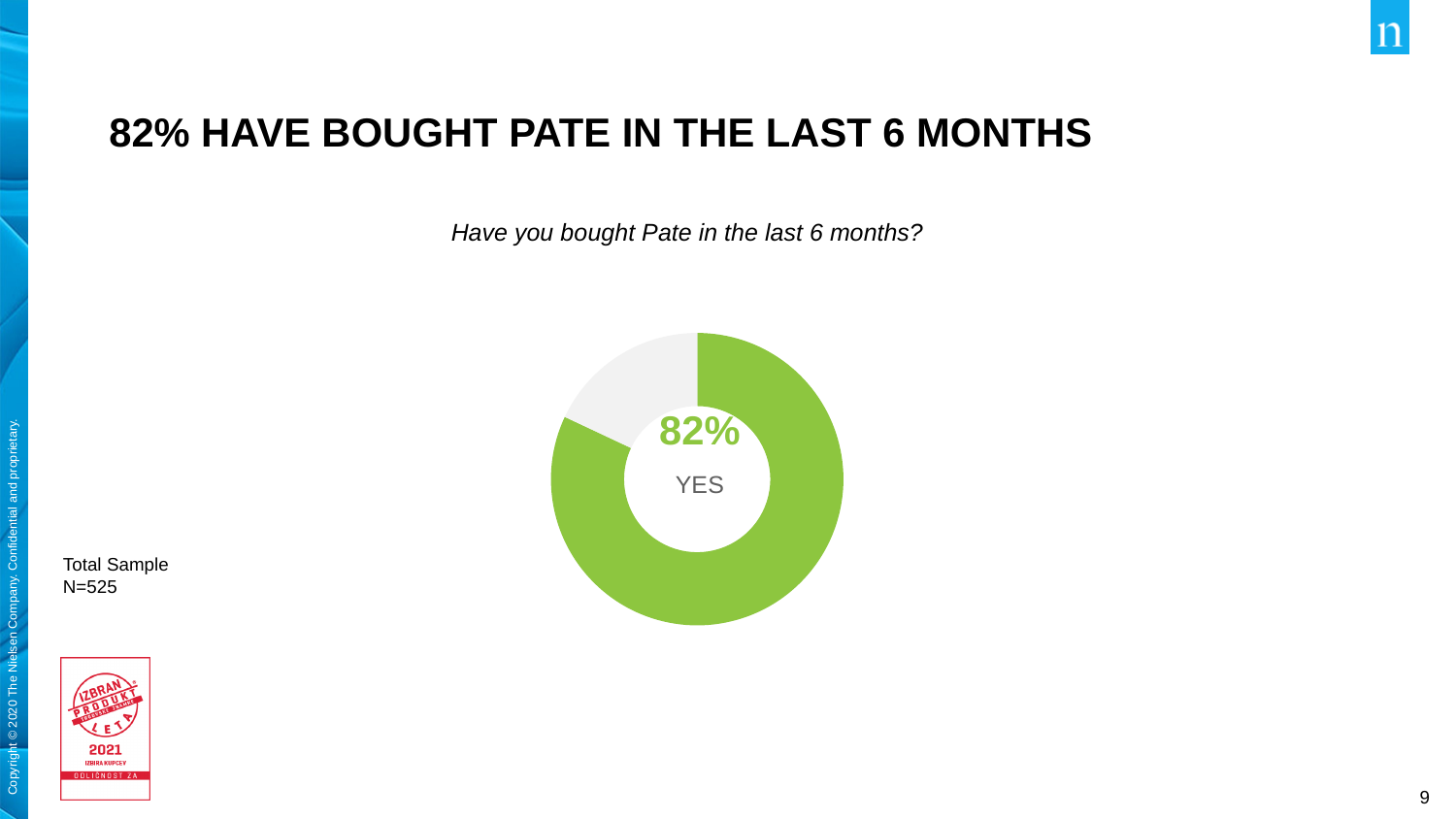
What percentage of respondents answered YES to having bought Pate in the last 6 months? 82% What share of the donut chart does the YES slice represent? 82% What question does the chart on the slide answer? Have you bought Pate in the last 6 months? Which slice of the donut chart is larger, the green YES slice or the grey slice? The green YES slice Is the YES share in the donut chart greater or less than 50%? greater What is the sample size (N) stated on the slide for the chart? N=525 What kind of chart is shown on the slide? Donut (pie) chart How many slices does the donut chart have? 2 What label is shown inside the donut chart below the percentage? YES